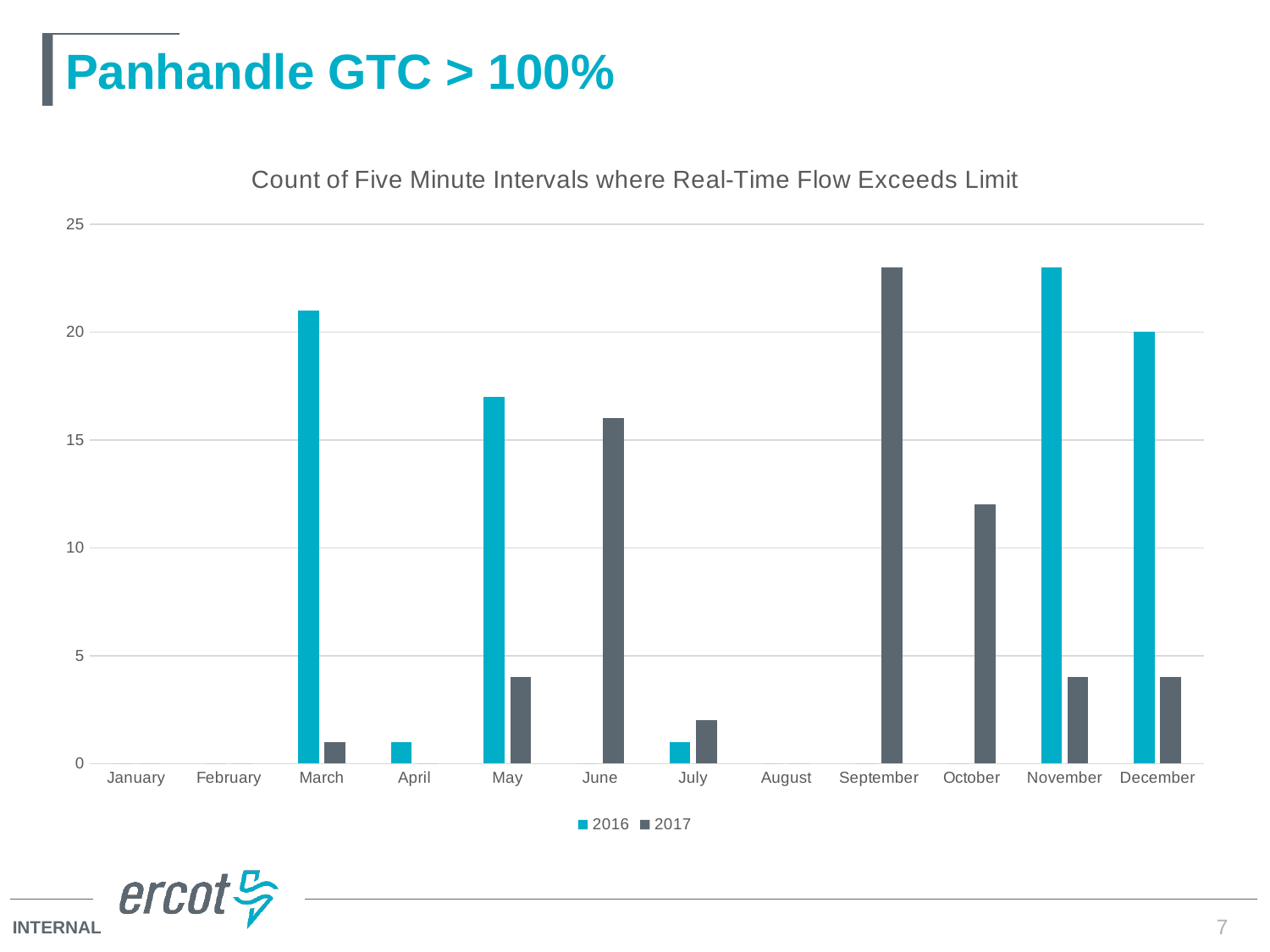
Is the value for June in the 2017 series greater or less than 15? greater Is the value for October in the 2017 series greater or less than 10? greater What is the title of the chart? Count of Five Minute Intervals where Real-Time Flow Exceeds Limit Which is larger for May: the 2016 value or the 2017 value? 2016 Is the value for May in the 2017 series greater or less than 5? less Which is larger for September: the 2016 value or the 2017 value? 2017 Which month has the highest value for the 2016 series? November What kind of chart is shown on the slide? bar chart How many months are shown on the x axis? 12 Which month has the highest value for the 2017 series? September How many series does the legend list? 2